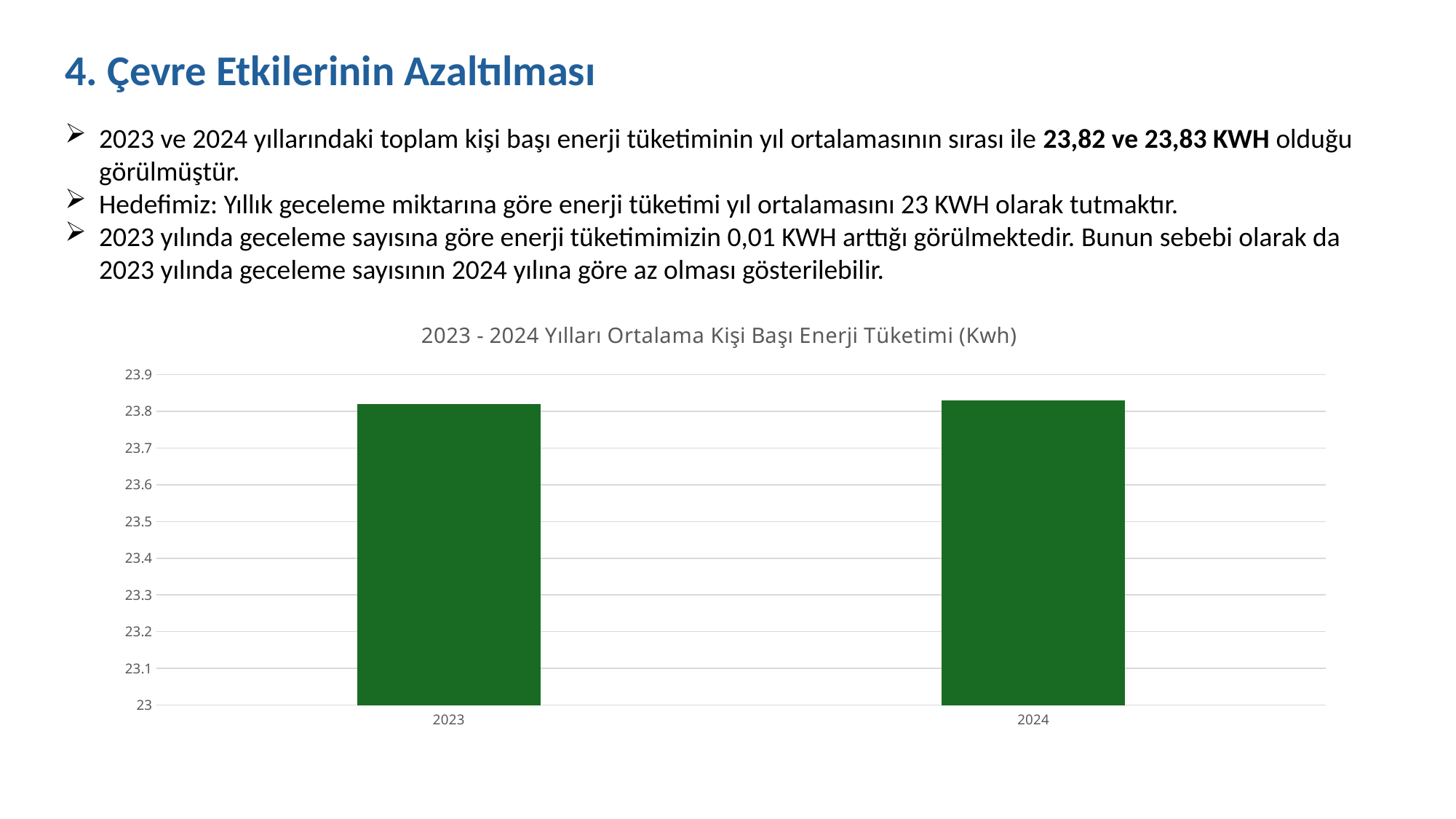
What is the title of the chart? 2023 - 2024 Yılları Ortalama Kişi Başı Enerji Tüketimi (Kwh) Is the value for 2024 greater or less than 23.7? greater Is the value for 2023 greater or less than 23.9? less Is the value for 2023 greater or less than 23.5? greater What kind of chart is shown on the slide? bar chart What is the lowest value shown on the y axis of the chart? 23 According to the slide, what was the average per-person energy consumption in 2023? 23,82 KWH How many years (categories) are plotted on the x axis of the chart? 2 What is the difference between the 2024 and 2023 average per-person energy consumption values stated on the slide? 0,01 KWH What colour are the bars in the chart? green According to the slide, what was the average per-person energy consumption in 2024? 23,83 KWH